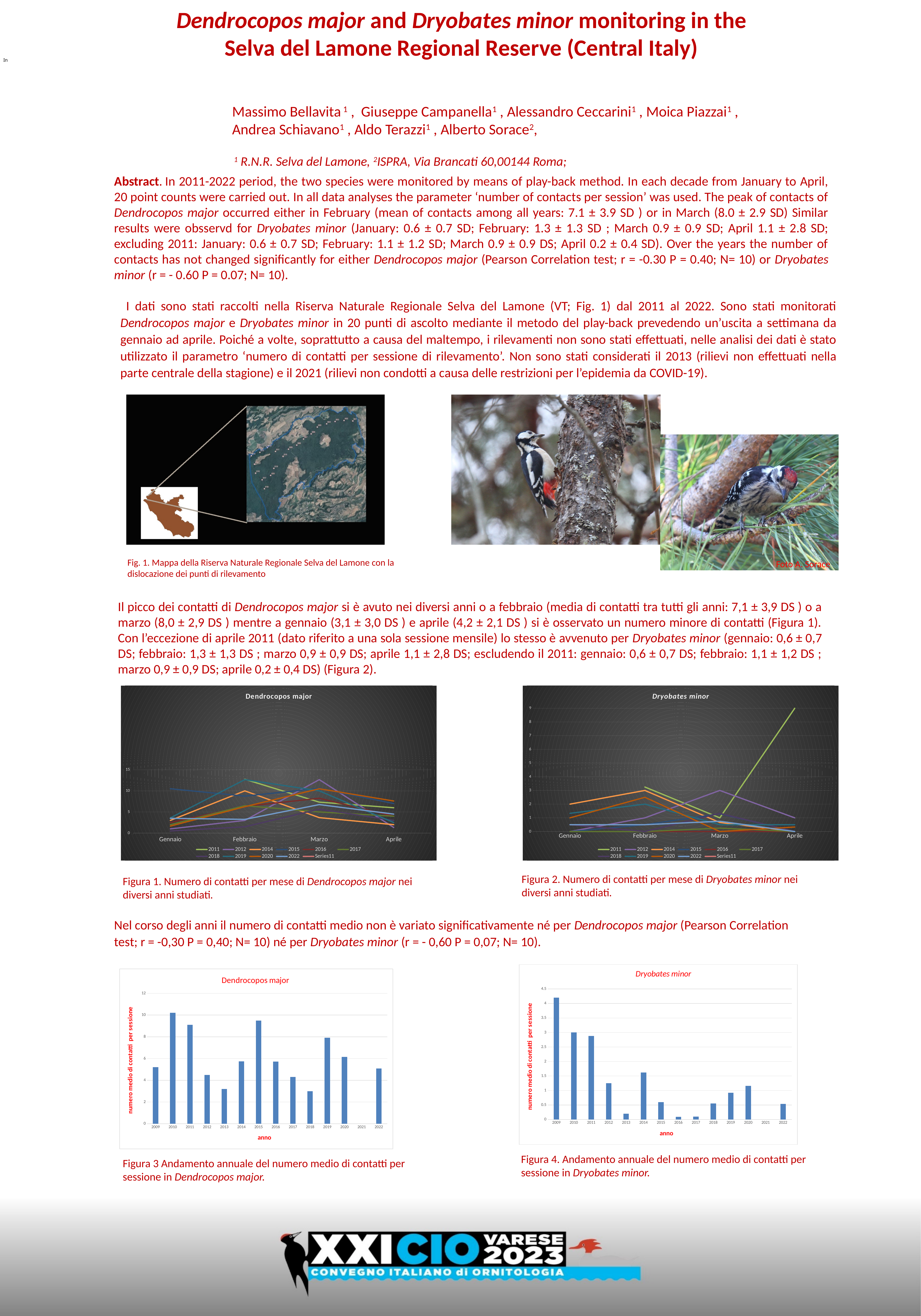
In the 'Dendrocopos major' bar chart (Figura 3), which year has the larger value, 2010 or 2019? 2010 What kind of chart is the 'Dryobates minor' chart in Figura 2 (middle right)? line chart What kind of chart is the 'Dendrocopos major' chart in Figura 3 (bottom left)? bar chart In the 'Dendrocopos major' bar chart (Figura 3), which year has the highest mean number of contacts per session? 2010 In the 'Dendrocopos major' bar chart (Figura 3), is the value for 2015 greater or less than 8? greater How many months are shown on the x axis of the 'Dendrocopos major' line chart (Figura 1)? 4 In the 'Dryobates minor' bar chart (Figura 4), is the value for 2012 greater or less than 1.5? less In the 'Dryobates minor' line chart (Figura 2), in which month does the 2011 series reach its highest value? Aprile How many entries does the legend of the 'Dryobates minor' line chart (Figura 2) list? 11 In the 'Dendrocopos major' bar chart (Figura 3), is the value for 2013 greater or less than 4? less In the 'Dryobates minor' bar chart (Figura 4), which year has the highest mean number of contacts per session? 2009